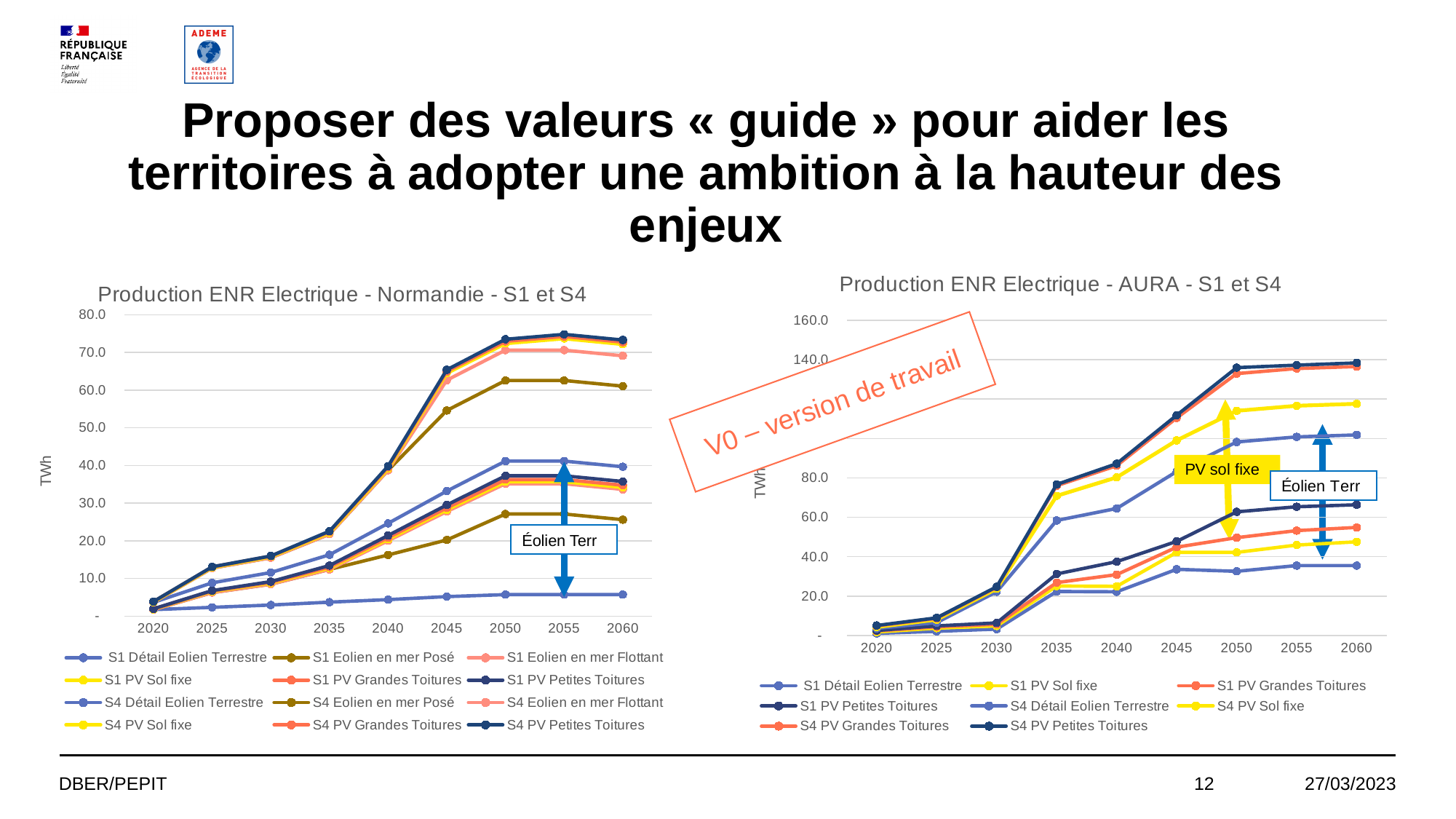
In the 'Production ENR Electrique - AURA - S1 et S4' chart, is the value for S1 Détail Eolien Terrestre in 2060 greater or less than 40.0? less In the 'Production ENR Electrique - Normandie - S1 et S4' chart, is the value for S1 Détail Eolien Terrestre in 2060 greater or less than 10.0? less In the 'Production ENR Electrique - AURA - S1 et S4' chart, is the value for S4 PV Petites Toitures in 2060 greater or less than 120.0? greater How many years are shown on the x axis of the 'Production ENR Electrique - AURA - S1 et S4' chart? 9 In the 'Production ENR Electrique - AURA - S1 et S4' chart, does the S4 PV Petites Toitures series rise or fall from 2020 to 2060? rise How many series does the legend of the 'Production ENR Electrique - Normandie - S1 et S4' chart list? 12 In the 'Production ENR Electrique - Normandie - S1 et S4' chart, which is larger in 2060: S4 PV Petites Toitures or S1 Détail Eolien Terrestre? S4 PV Petites Toitures How many series does the legend of the 'Production ENR Electrique - AURA - S1 et S4' chart list? 8 What unit is shown on the y axis of the 'Production ENR Electrique - Normandie - S1 et S4' chart? TWh In the 'Production ENR Electrique - AURA - S1 et S4' chart, which is larger in 2060: S4 PV Sol fixe or S1 PV Sol fixe? S4 PV Sol fixe What kind of chart is the 'Production ENR Electrique - Normandie - S1 et S4' chart? line chart